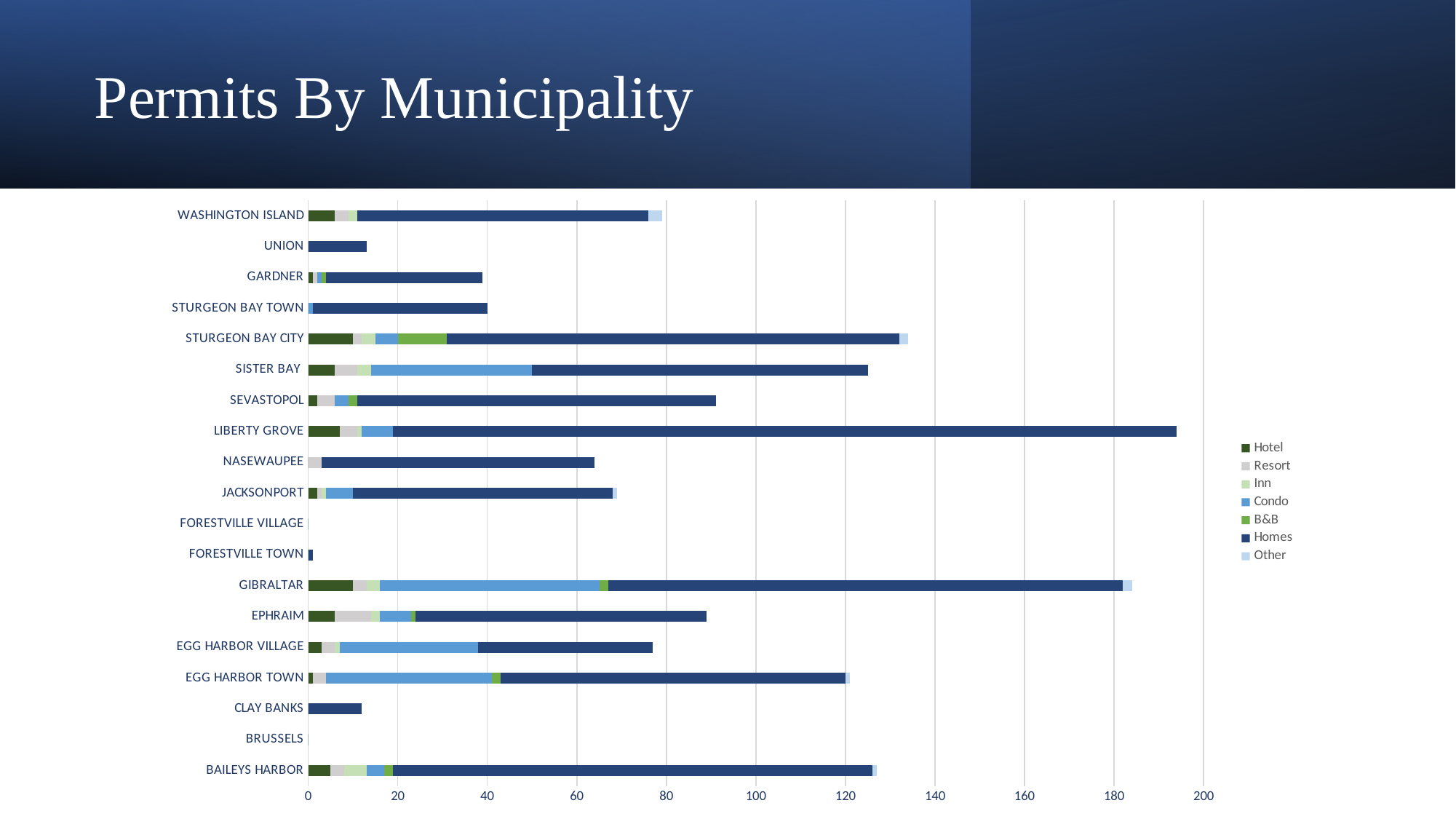
Is the total value for Egg Harbor Town greater or less than 100? greater Is the total value for Sevastopol greater or less than 80? greater What is the title of the slide? Permits By Municipality Which municipality has the longest total bar? Liberty Grove Is the total value for Nasewaupee greater or less than 80? less What kind of chart is shown on the slide? Stacked bar chart How many series does the legend list? 7 Which has the larger total bar, Sturgeon Bay City or Sevastopol? Sturgeon Bay City How many municipalities are listed on the vertical axis? 19 Which has the larger total bar, Gibraltar or Ephraim? Gibraltar